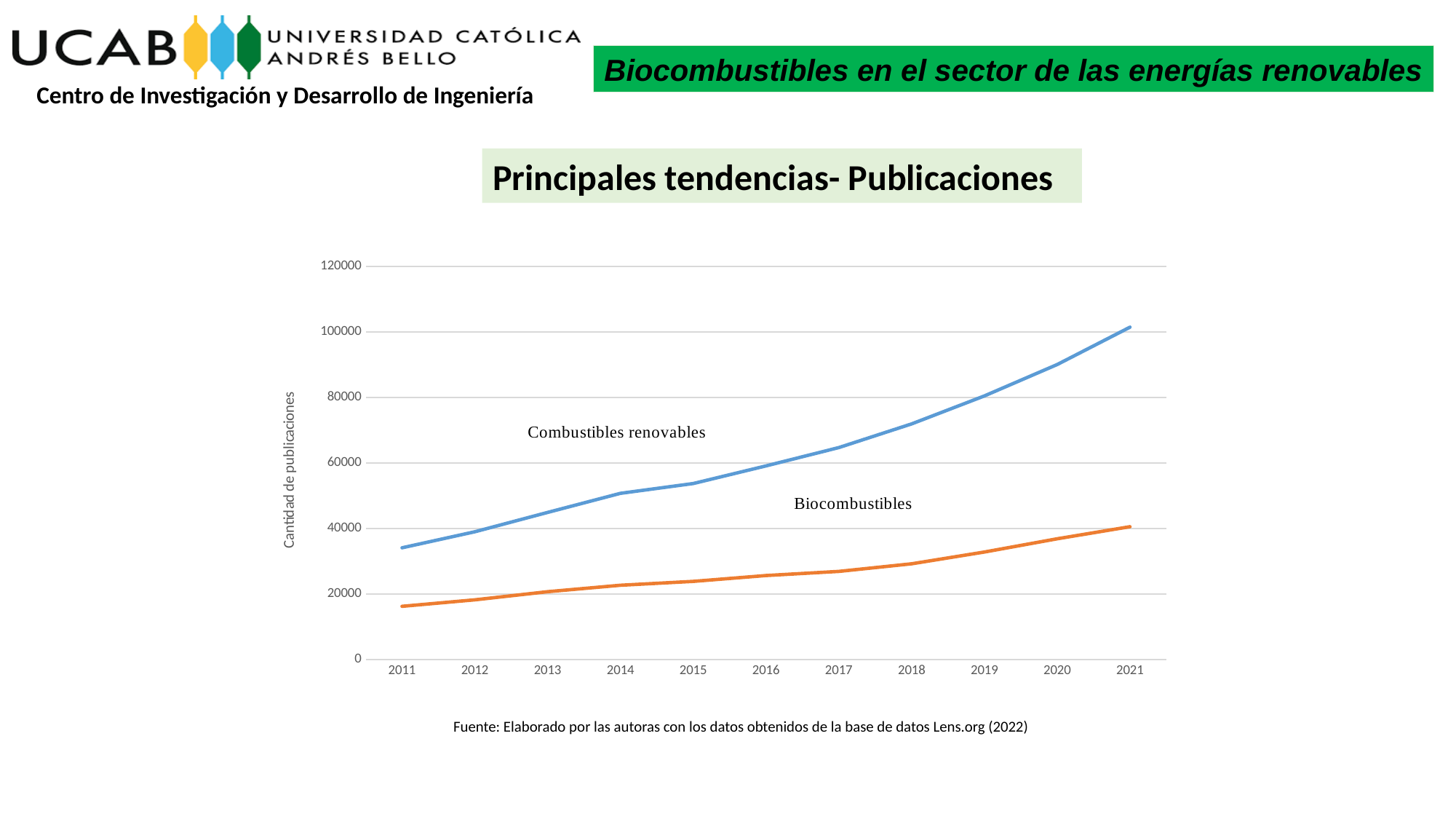
In which year is the value for Combustibles renovables highest? 2021 What kind of chart is shown on the slide? line chart How many lines (series) are plotted in the chart? 2 In which year is the value for Biocombustibles lowest? 2011 Which series is drawn with the blue line? Combustibles renovables In 2015, which series has the larger value, Combustibles renovables or Biocombustibles? Combustibles renovables Do the values for Biocombustibles rise or fall from 2011 to 2021? rise Do the values for Combustibles renovables rise or fall from 2011 to 2021? rise Is the value for Combustibles renovables in 2011 greater or less than 40000? less Is the value for Combustibles renovables in 2020 greater or less than 80000? greater What is the label of the y axis of the chart? Cantidad de publicaciones How many years are plotted along the x axis of the chart? 11